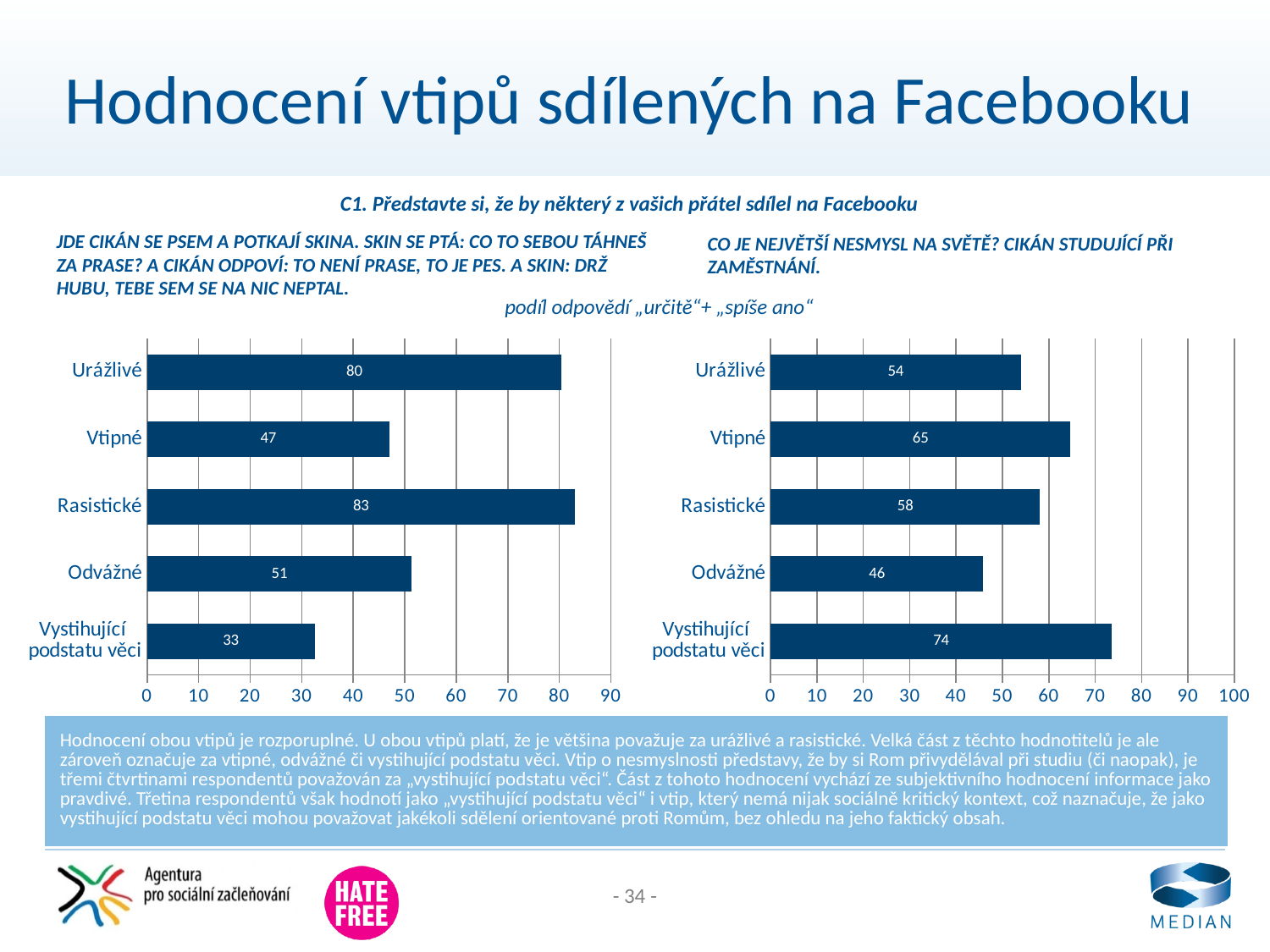
In the right chart, which category has the highest value? Vystihující podstatu věci In the right chart, which is larger, the value for Vtipné or the value for Rasistické? Vtipné In the left chart, what is the value for Rasistické? 83 In the left chart, which category has the lowest value? Vystihující podstatu věci In the left chart, which category has the highest value? Rasistické What type of chart is the right chart? Bar chart In the right chart, what is the value for Vystihující podstatu věci? 74 In the right chart, which category has the lowest value? Odvážné In the left chart, what is the value for Vtipné? 47 How many categories does the left chart show? 5 In the left chart, what is the difference between the values for Urážlivé and Vystihující podstatu věci? 47 In the right chart, what is the value for Odvážné? 46